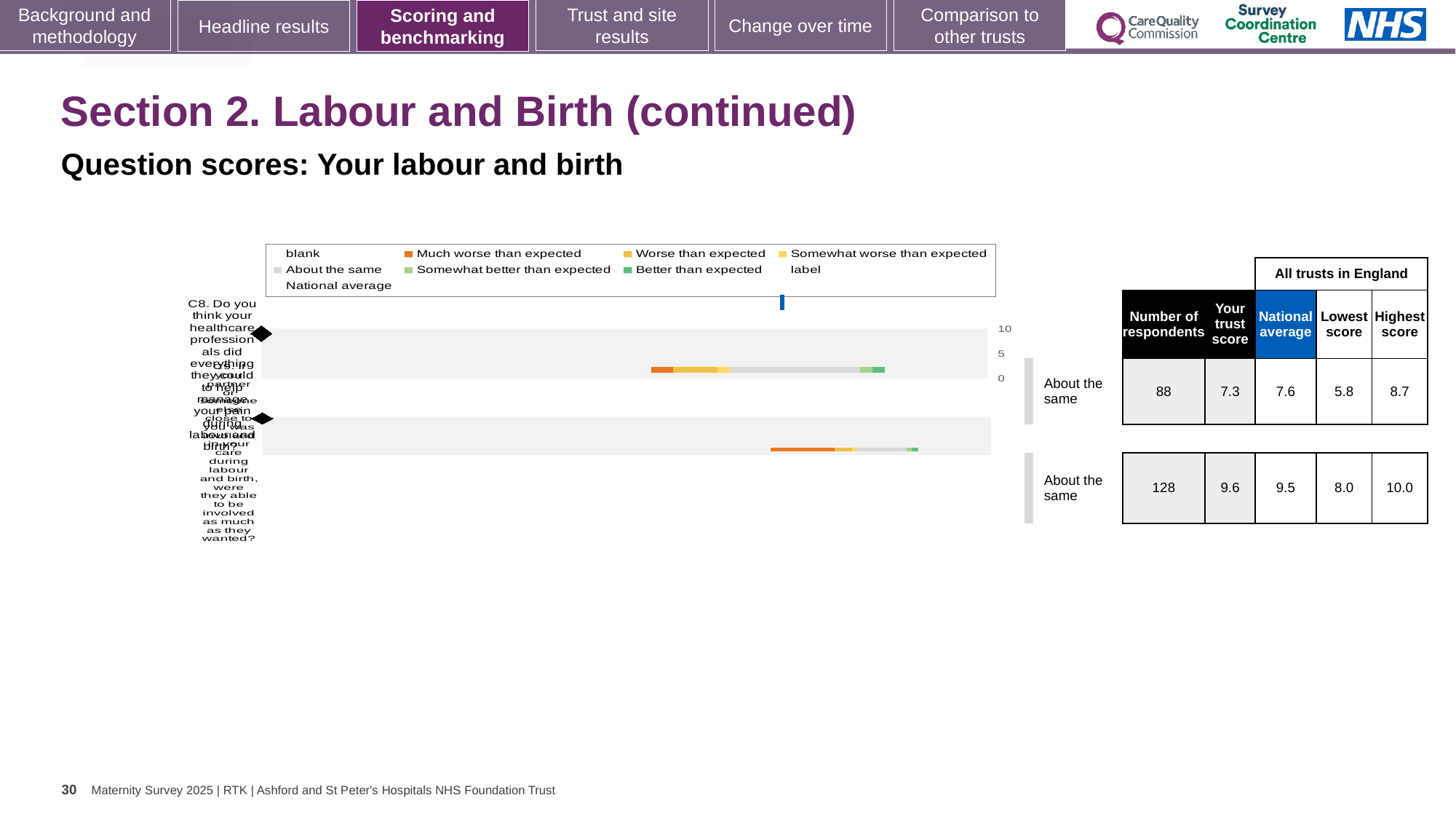
In the table beside the chart, what is the number of respondents for the first question row (C8, managing pain during labour and birth)? 88 What colour does the chart legend use for 'Much worse than expected'? Orange How many question rows (categories) are plotted in the chart? 2 In the table beside the chart, what is 'Your trust score' for the first question row (C8)? 7.3 What colour does the chart legend use for 'Better than expected'? Green Which question row has the higher 'Your trust score' in the table: the first (C8) or the second? The second In the table beside the chart, what is the national average for the second question row? 9.5 In the table beside the chart, what is the lowest score across all trusts in England for the first question row (C8)? 5.8 What kind of chart is shown on the slide? Horizontal bar chart What benchmark category is shown next to both question rows in the chart? About the same What is the difference between the trust scores of the second question row (9.6) and the first question row (7.3)? 2.3 In the table beside the chart, what is the highest score across all trusts in England for the second question row? 10.0